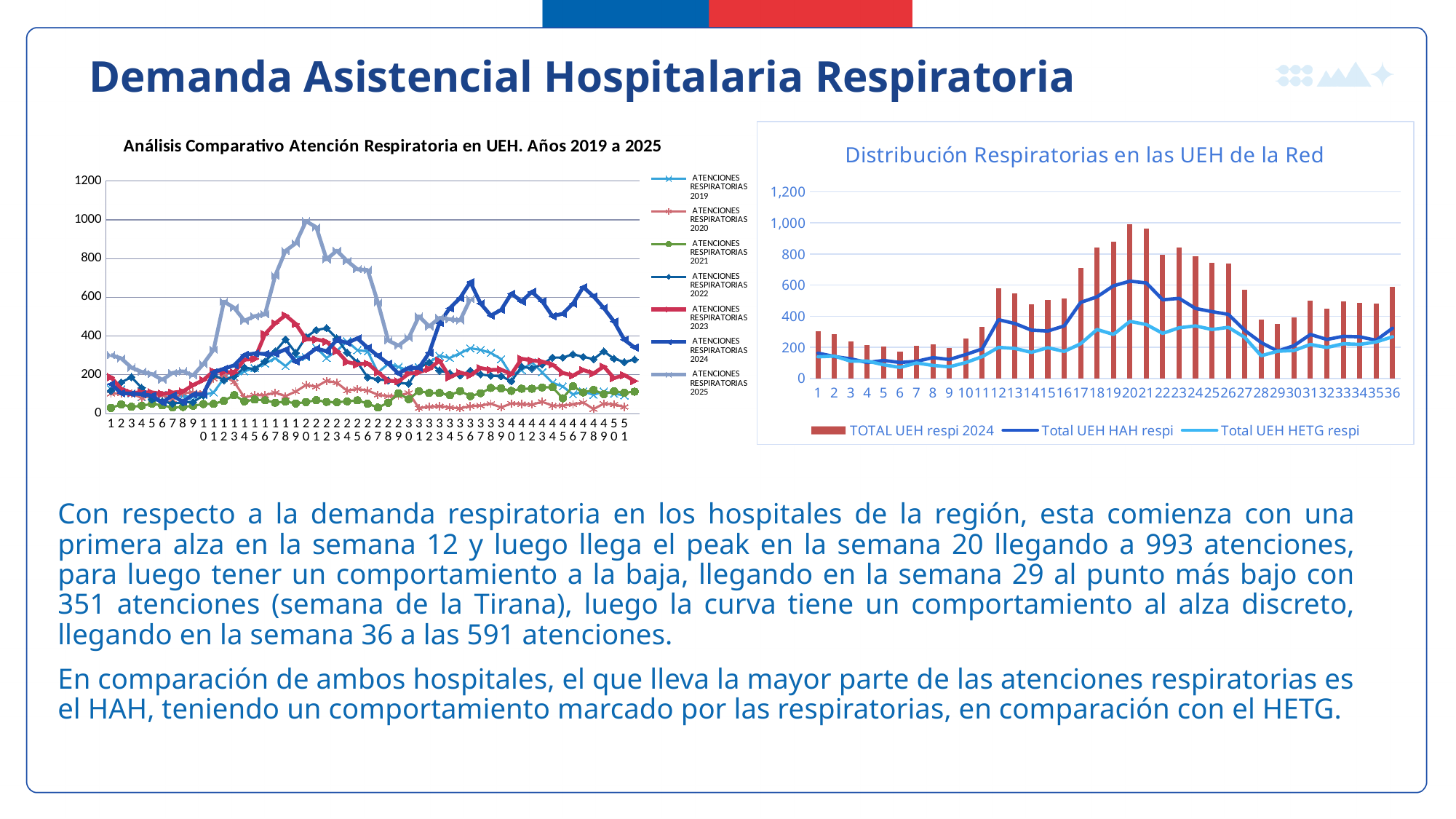
What type of chart is the 'Análisis Comparativo Atención Respiratoria en UEH. Años 2019 a 2025' chart? Line chart How many weeks are shown on the x axis of the 'Distribución Respiratorias en las UEH de la Red' chart? 36 What type of chart is the 'Distribución Respiratorias en las UEH de la Red' chart? Combined bar and line chart How many series does the legend of the 'Distribución Respiratorias en las UEH de la Red' chart list? 3 In the 'Análisis Comparativo Atención Respiratoria en UEH' chart, which series reaches the highest peak? ATENCIONES RESPIRATORIAS 2025 In the 'Distribución Respiratorias en las UEH de la Red' chart, is the TOTAL UEH respi 2024 bar for week 20 greater or less than 800? greater How many series does the legend of the 'Análisis Comparativo Atención Respiratoria en UEH' chart list? 7 In the 'Distribución Respiratorias en las UEH de la Red' chart, which week has the highest TOTAL UEH respi 2024 bar? 20 In the 'Distribución Respiratorias en las UEH de la Red' chart, is the TOTAL UEH respi 2024 bar for week 1 greater or less than 400? less In the 'Distribución Respiratorias en las UEH de la Red' chart, which is larger at week 20: Total UEH HAH respi or Total UEH HETG respi? Total UEH HAH respi In the 'Distribución Respiratorias en las UEH de la Red' chart, do the TOTAL UEH respi 2024 bars rise or fall from week 10 to week 20? Rise